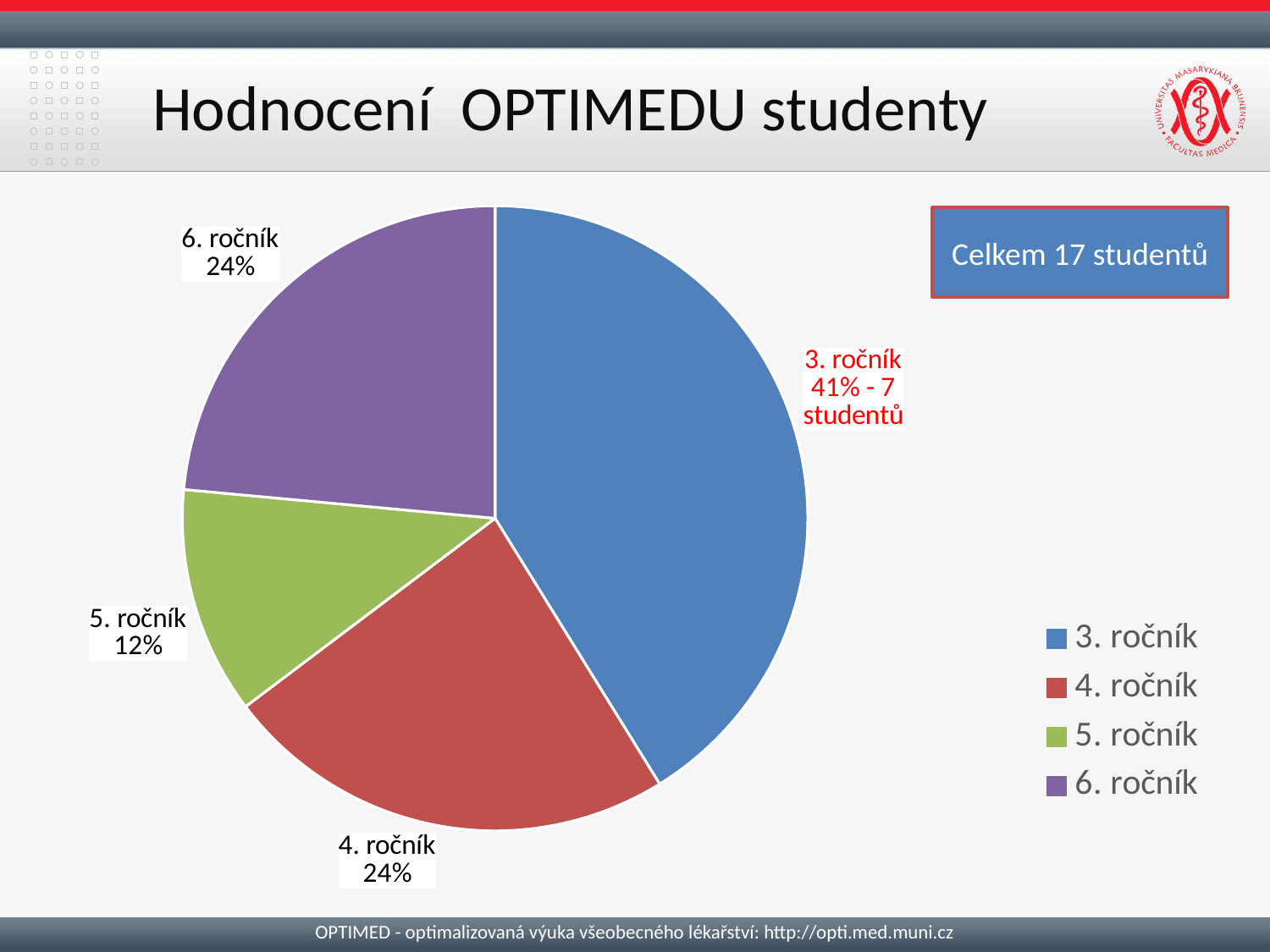
Which category has the smallest slice of the pie? 5. ročník What is the difference in percentage points between the 3. ročník and 5. ročník slices? 29 How many students are in 3. ročník according to the chart label? 7 Which slice is larger, 3. ročník or 4. ročník? 3. ročník What share of the pie does 4. ročník hold? 24% What share of the pie does 3. ročník hold? 41% Which category has the largest slice of the pie? 3. ročník What share of the pie does 6. ročník hold? 24% What is the total number of students stated on the slide? 17 What kind of chart is shown on the slide? pie chart How many categories does the pie chart show? 4